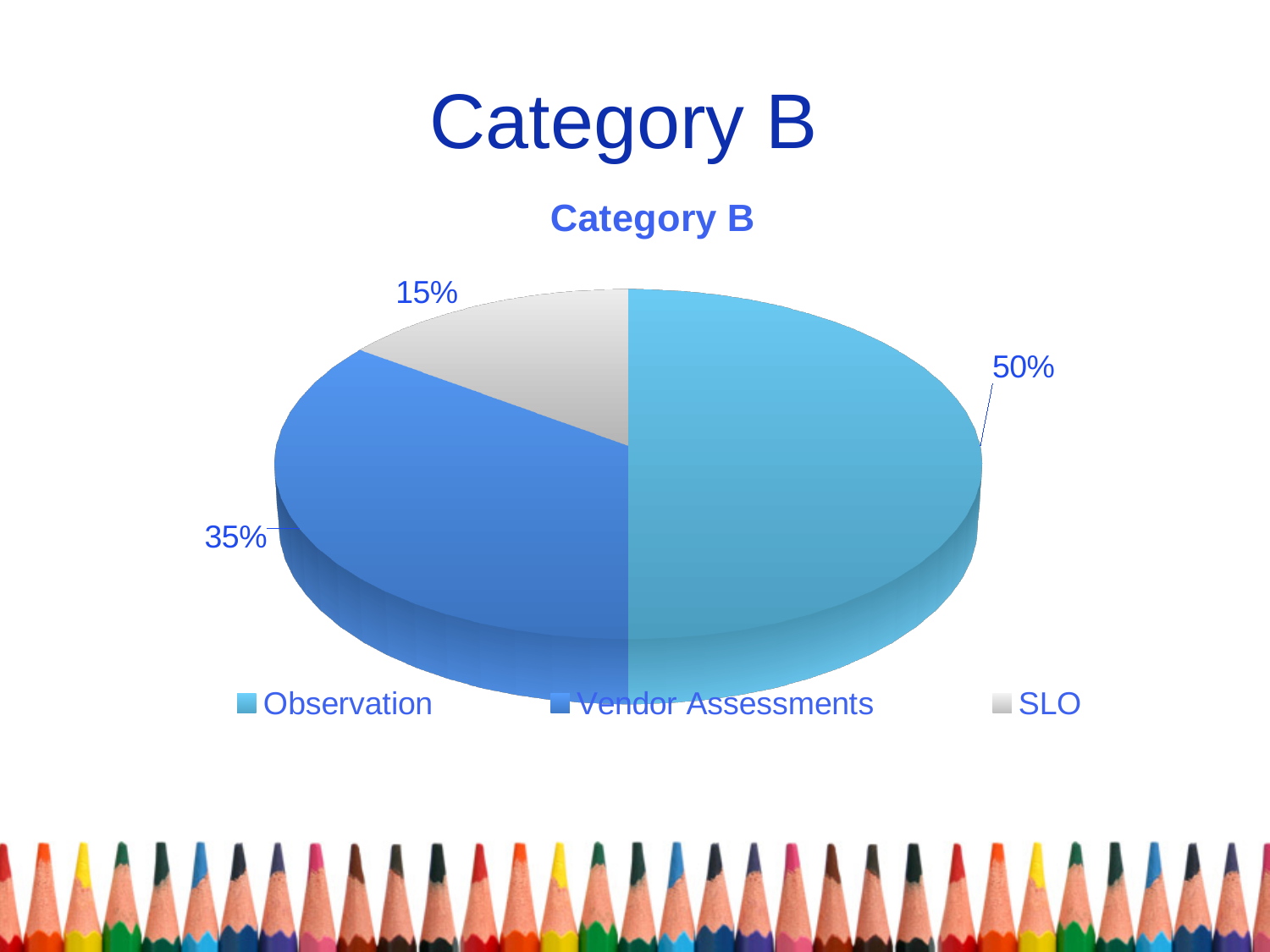
What kind of chart is shown on the slide? Pie chart What colour is the SLO slice in the pie chart? Grey What share of the pie does SLO have? 15% What is the difference in percentage points between Vendor Assessments and SLO? 20 Which category has the largest slice of the pie? Observation What is the title of the chart? Category B How many categories are shown in the pie chart? 3 What share of the pie does Observation have? 50% What is the difference in percentage points between Observation and Vendor Assessments? 15 Which category has the smallest slice of the pie? SLO What share of the pie does Vendor Assessments have? 35% Which is larger, the Vendor Assessments slice or the SLO slice? Vendor Assessments